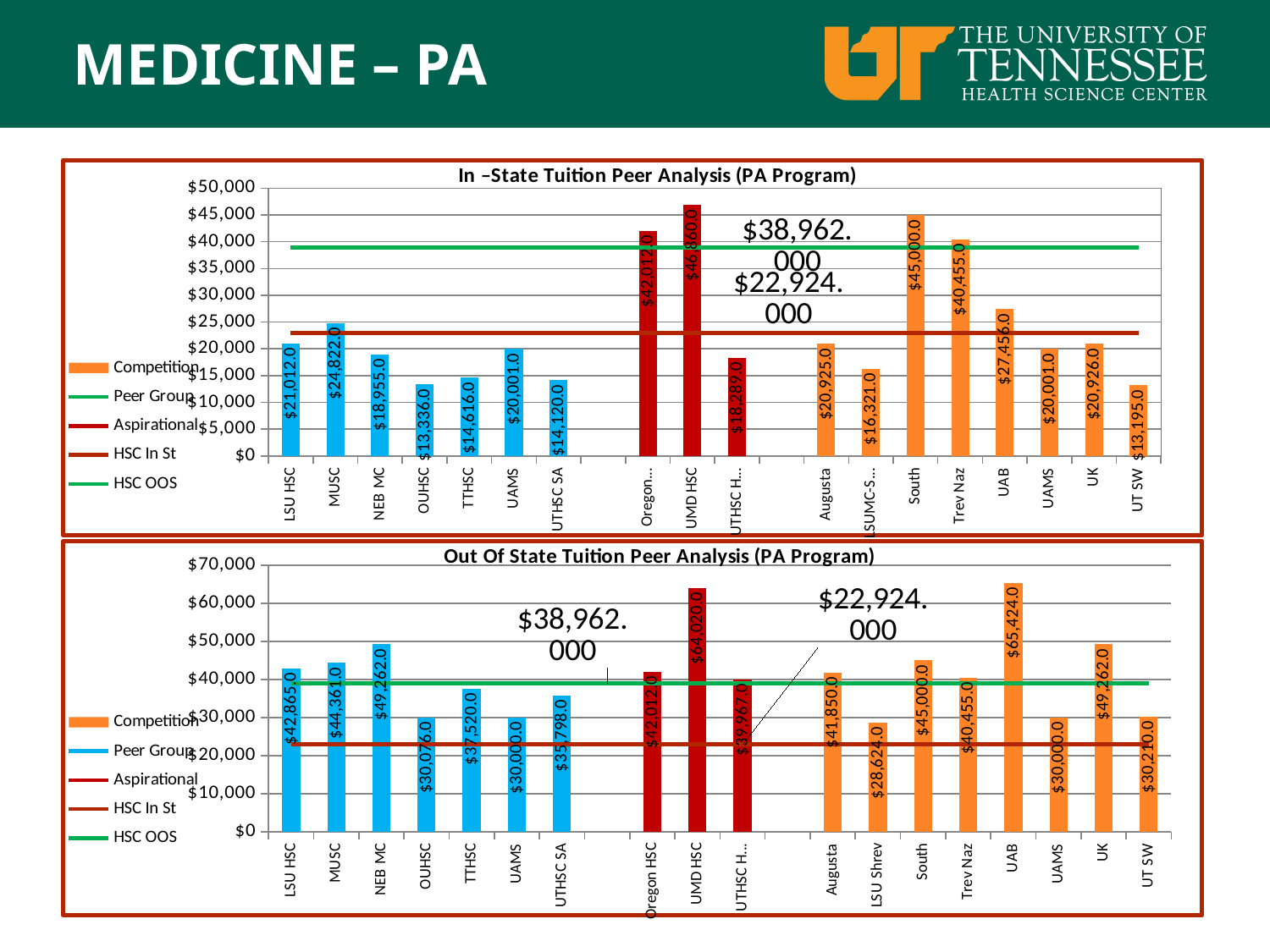
In the In-State Tuition Peer Analysis chart, which is larger, the value for NEB MC or the value for UAB? UAB In the In-State Tuition Peer Analysis chart, what is the difference between UMD HSC and South? $1,860.0 In the In-State Tuition Peer Analysis chart, what is the value for MUSC? $24,822.0 In the Out Of State Tuition Peer Analysis chart, which institution has the lowest tuition? LSU Shrev In the In-State Tuition Peer Analysis chart, which institution has the highest tuition? UMD HSC In the In-State Tuition Peer Analysis chart, how many entries does the legend list? 5 In the In-State Tuition Peer Analysis chart, what is the value for South? $45,000.0 In the Out Of State Tuition Peer Analysis chart, what is the value for UMD HSC? $64,020.0 What kind of chart is the Out Of State Tuition Peer Analysis chart? Bar chart In the Out Of State Tuition Peer Analysis chart, how many bars are plotted? 18 In the Out Of State Tuition Peer Analysis chart, which institution has the highest tuition? UAB In the Out Of State Tuition Peer Analysis chart, what is the difference between NEB MC and OUHSC? $19,186.0